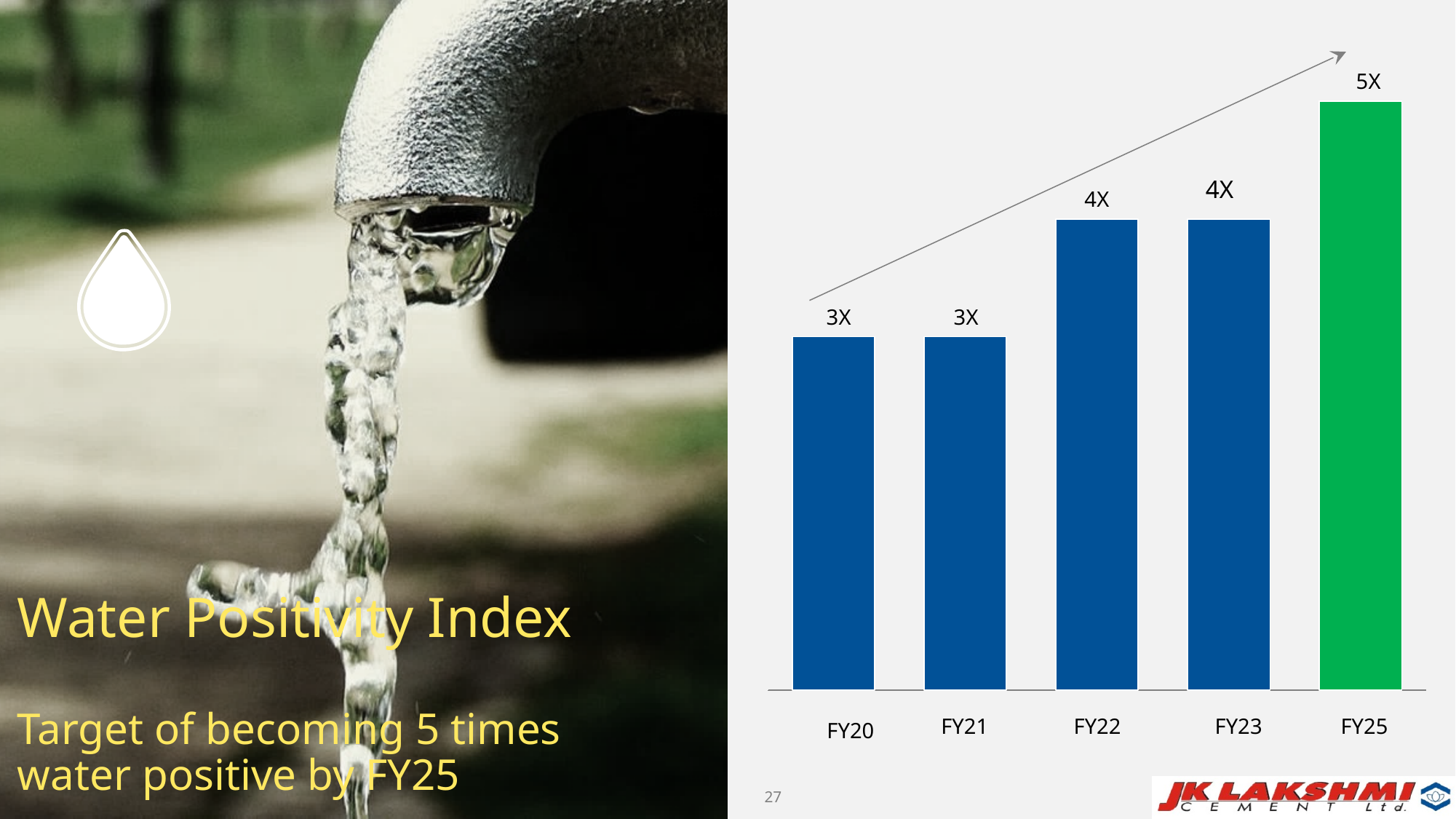
Which bar is coloured green rather than blue? FY25 How many years are shown on the x axis? 5 What kind of chart is shown? Bar chart What is the value for FY25? 5X What is the value for FY22? 4X What is the value for FY20? 3X Do the values rise or fall from FY20 to FY25? Rise Which of FY21 and FY22 has the larger value? FY22 What is the difference between the FY25 value and the FY20 value? 2X Which year has the highest value? FY25 What is the title shown on the slide for this chart? Water Positivity Index What is the value for FY23? 4X